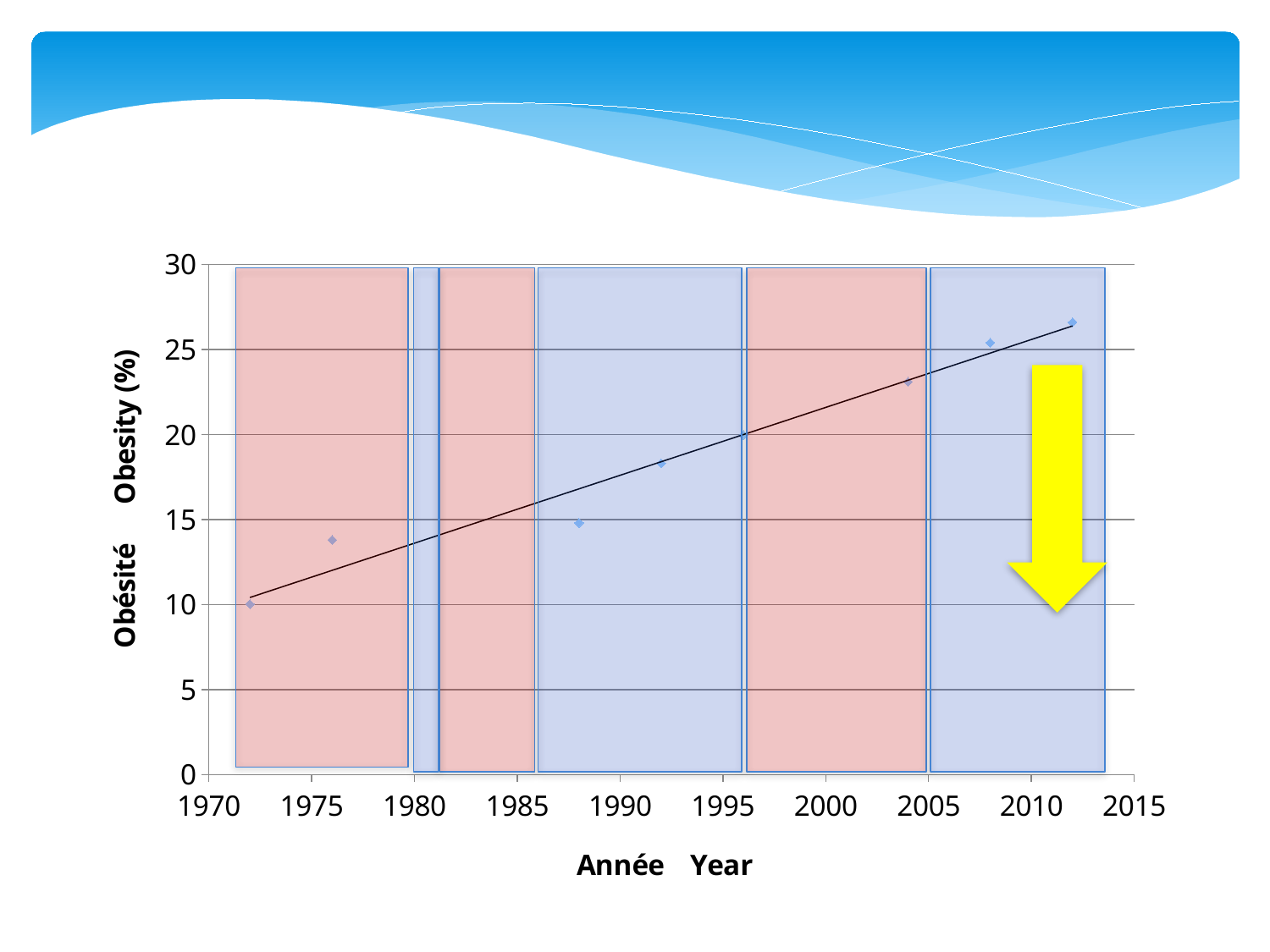
Is the obesity value for 2012 greater or less than 25? greater What is the title of the horizontal axis? Année Year What is the title of the vertical axis? Obésité Obesity (%) Is the obesity value for 2004 greater or less than 25? less Which year has the lowest plotted obesity value? 1972 Do the plotted obesity values rise or fall as the year increases along the x axis? rise Which has the larger obesity value, 1992 or 2004? 2004 Which year has the highest plotted obesity value? 2012 What kind of chart is shown on the slide? scatter chart How many data points are plotted on the chart? 8 Is the obesity value for 1992 greater or less than 15? greater